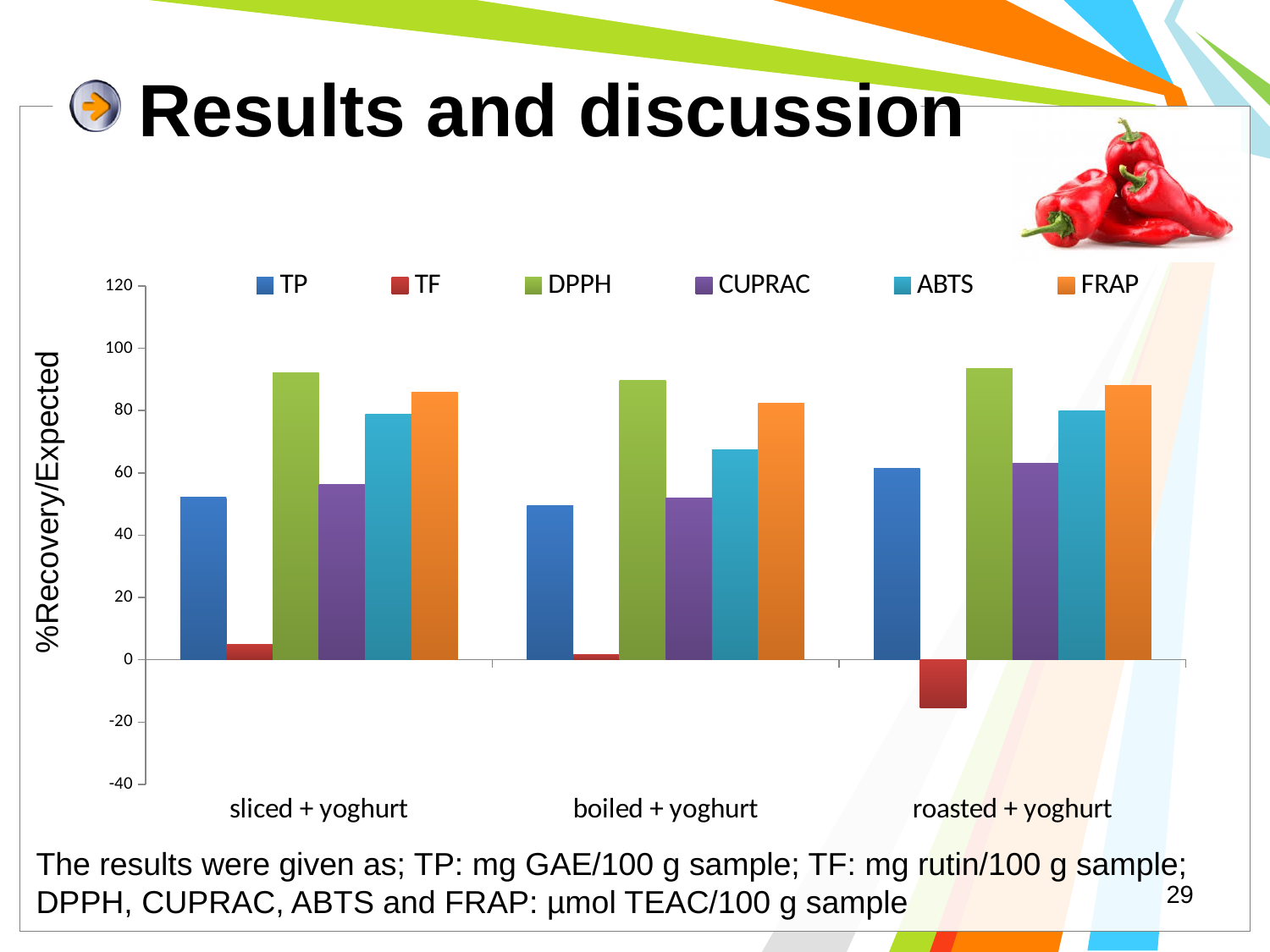
Is the value for CUPRAC in the boiled + yoghurt category greater or less than 60? less Which series has the lowest value in the roasted + yoghurt category? TF Is the value for TF in the roasted + yoghurt category greater or less than 0? less How many categories are shown on the x axis? 3 Is the value for TP in the sliced + yoghurt category greater or less than 40? greater What is the title of the y axis? %Recovery/Expected Which series has the highest value in the boiled + yoghurt category? DPPH What kind of chart is shown on the slide? bar chart How many series does the legend list? 6 Which category has the larger TP value, roasted + yoghurt or boiled + yoghurt? roasted + yoghurt Which category has the larger ABTS value, sliced + yoghurt or boiled + yoghurt? sliced + yoghurt